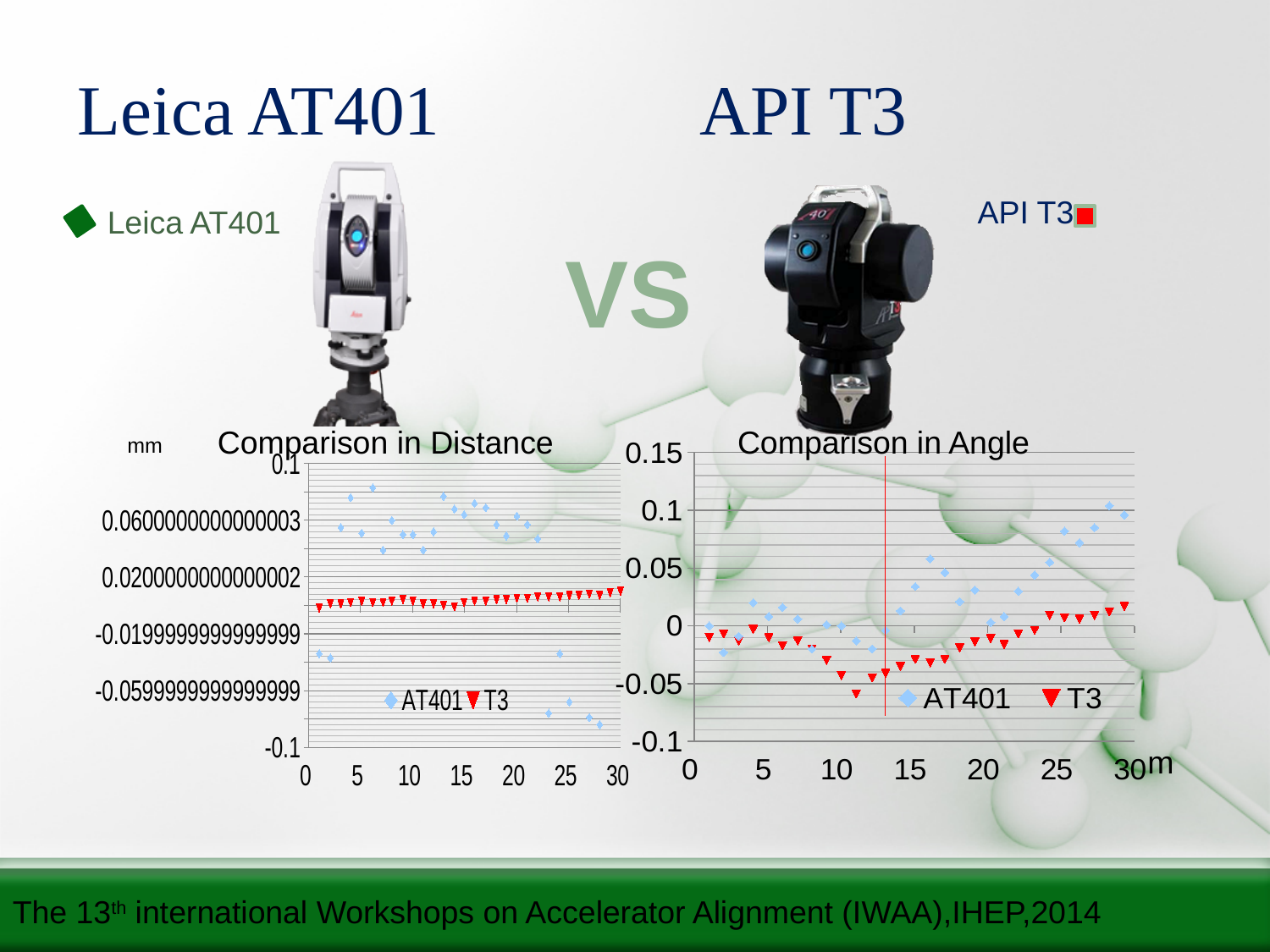
In the "Comparison in Angle" chart, is the T3 value at about 11 on the x axis greater or less than -0.05? less In the "Comparison in Distance" chart, is the T3 value at about 30 on the x axis greater or less than 0.02? less What kind of chart is the "Comparison in Angle" chart? scatter chart What is the highest value shown on the y axis of the "Comparison in Angle" chart? 0.15 In the "Comparison in Distance" chart, which series is plotted with blue diamonds? AT401 In the "Comparison in Angle" chart, is the AT401 value at about 28 on the x axis greater or less than 0.05? greater In the "Comparison in Angle" chart, which series is plotted with red triangles? T3 What kind of chart is the "Comparison in Distance" chart? scatter chart How many series does the legend of the "Comparison in Angle" chart list? 2 How many series does the legend of the "Comparison in Distance" chart list? 2